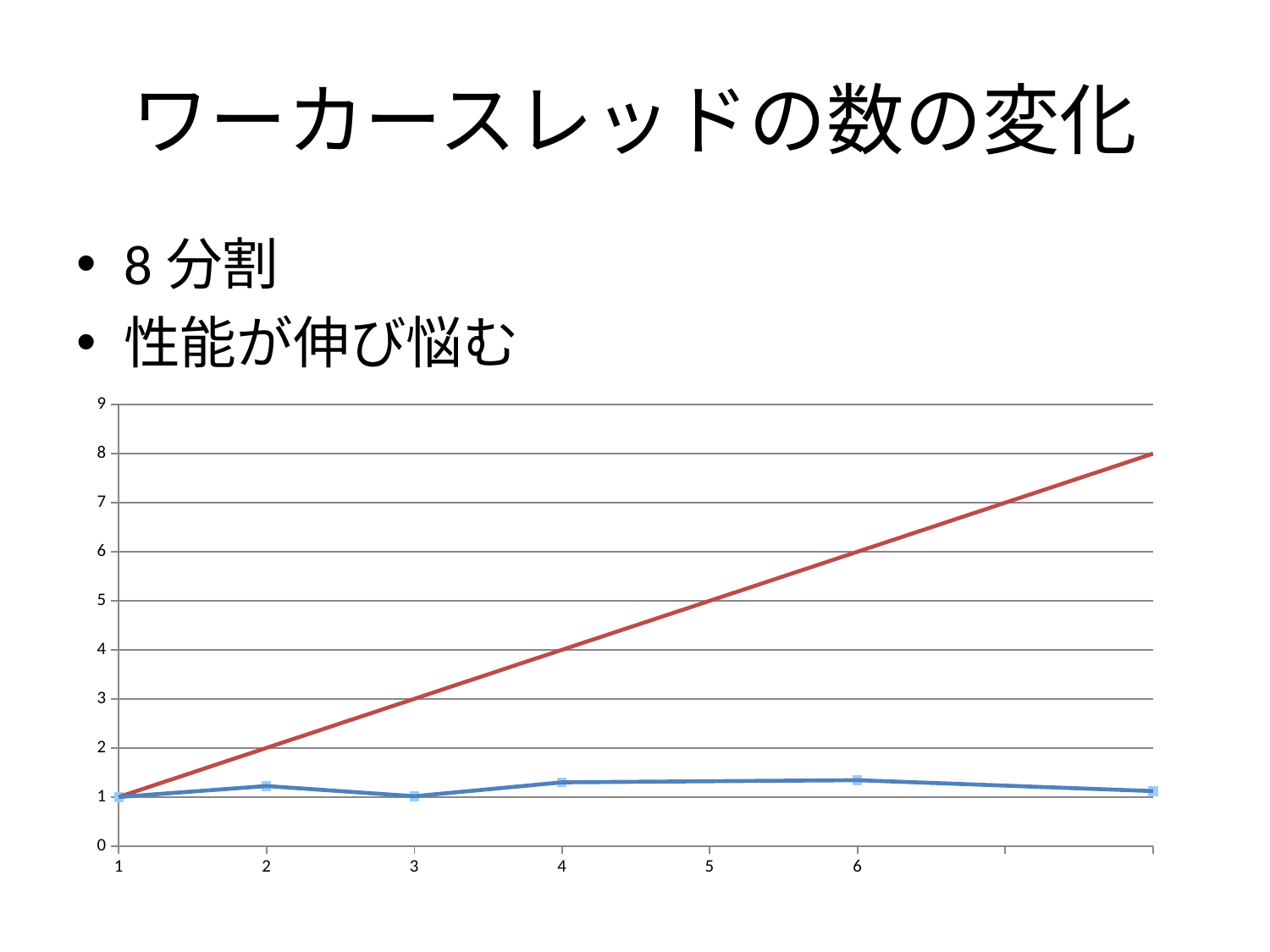
What is the highest tick value shown on the y axis? 9 What is the value of the red line at x = 3? 3 What is the value of the blue line at x = 1? 1 What is the value of the red line at x = 6? 6 Does the red line rise or fall as x increases? rises How many lines are plotted on the chart? 2 What colour is the straight diagonal line on the chart? red Is the value of the red line at x = 6 greater or less than 5? greater At x = 4, which line has the larger value, the red line or the blue line? the red line What kind of chart is shown on the slide? line chart Is the value of the blue line at x = 6 greater or less than 2? less